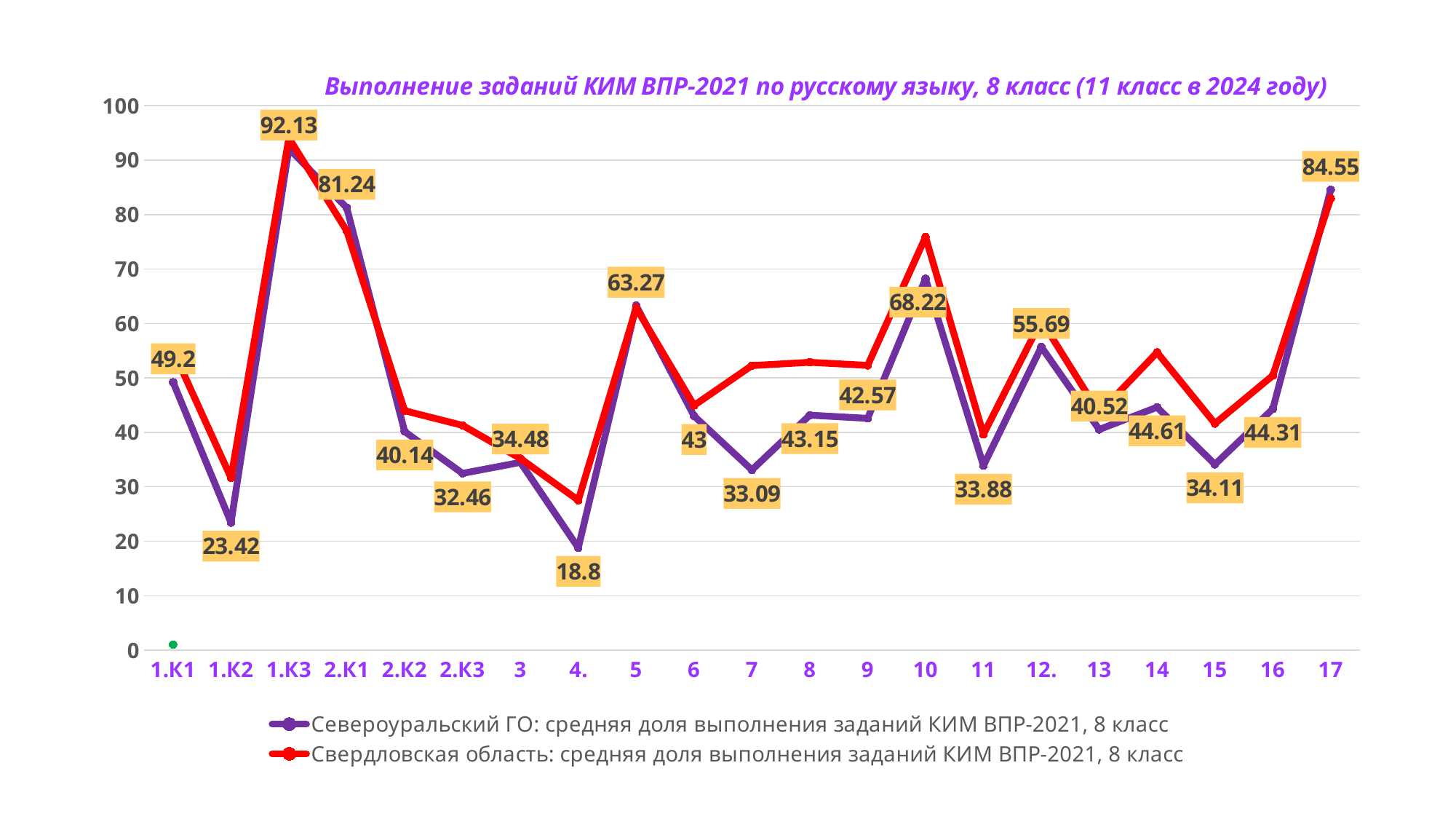
What is the difference between the Североуральский ГО values at 1.К3 and 4.? 73.33 What type of chart is shown on the slide? line chart At which category is the Североуральский ГО series lowest? 4. What is the value for Североуральский ГО at category 17? 84.55 How many categories are shown on the x axis? 21 At which category is the Североуральский ГО series highest? 1.К3 How many series does the legend list? 2 What is the value for Североуральский ГО at category 4.? 18.8 At category 8, which series has the larger value: Североуральский ГО or Свердловская область? Свердловская область What colour is the line for Свердловская область? red What is the value for Североуральский ГО at category 1.К3? 92.13 Is the value for Свердловская область at category 10 greater or less than 70? greater